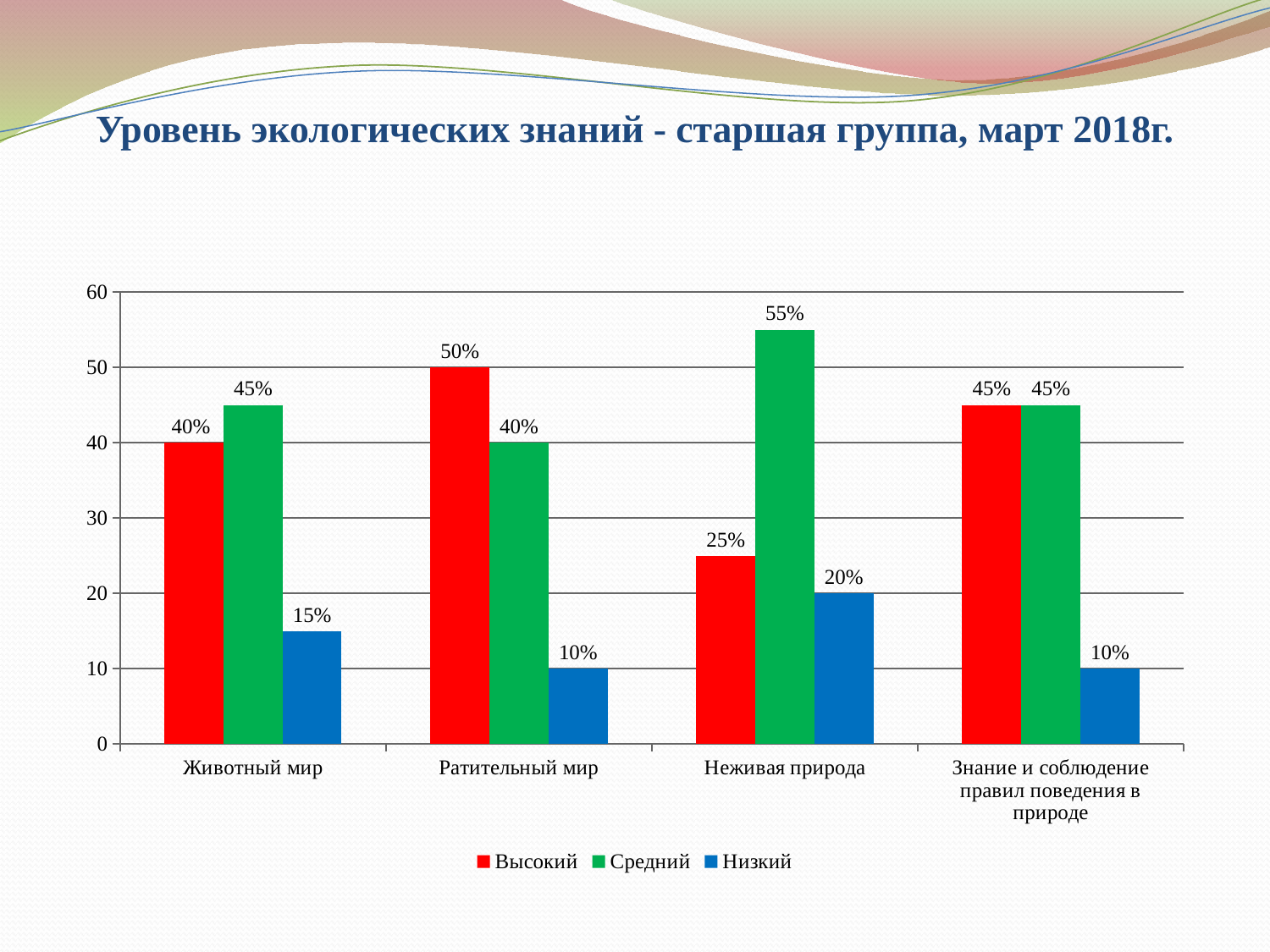
Which category has the lowest Высокий value? Неживая природа What is the value for Низкий in the Ратительный мир category? 10% Which is larger in the Животный мир category: Высокий or Средний? Средний What is the value for Средний in the Неживая природа category? 55% What colour represents the Низкий series? Blue How many categories are shown on the x axis? 4 What is the value for Высокий in the Животный мир category? 40% What is the value for Низкий in the Неживая природа category? 20% What kind of chart is shown on the slide? Bar chart How many series does the legend list? 3 Which category has the highest Средний value? Неживая природа What is the difference between the Высокий and Низкий values in the Ратительный мир category? 40%